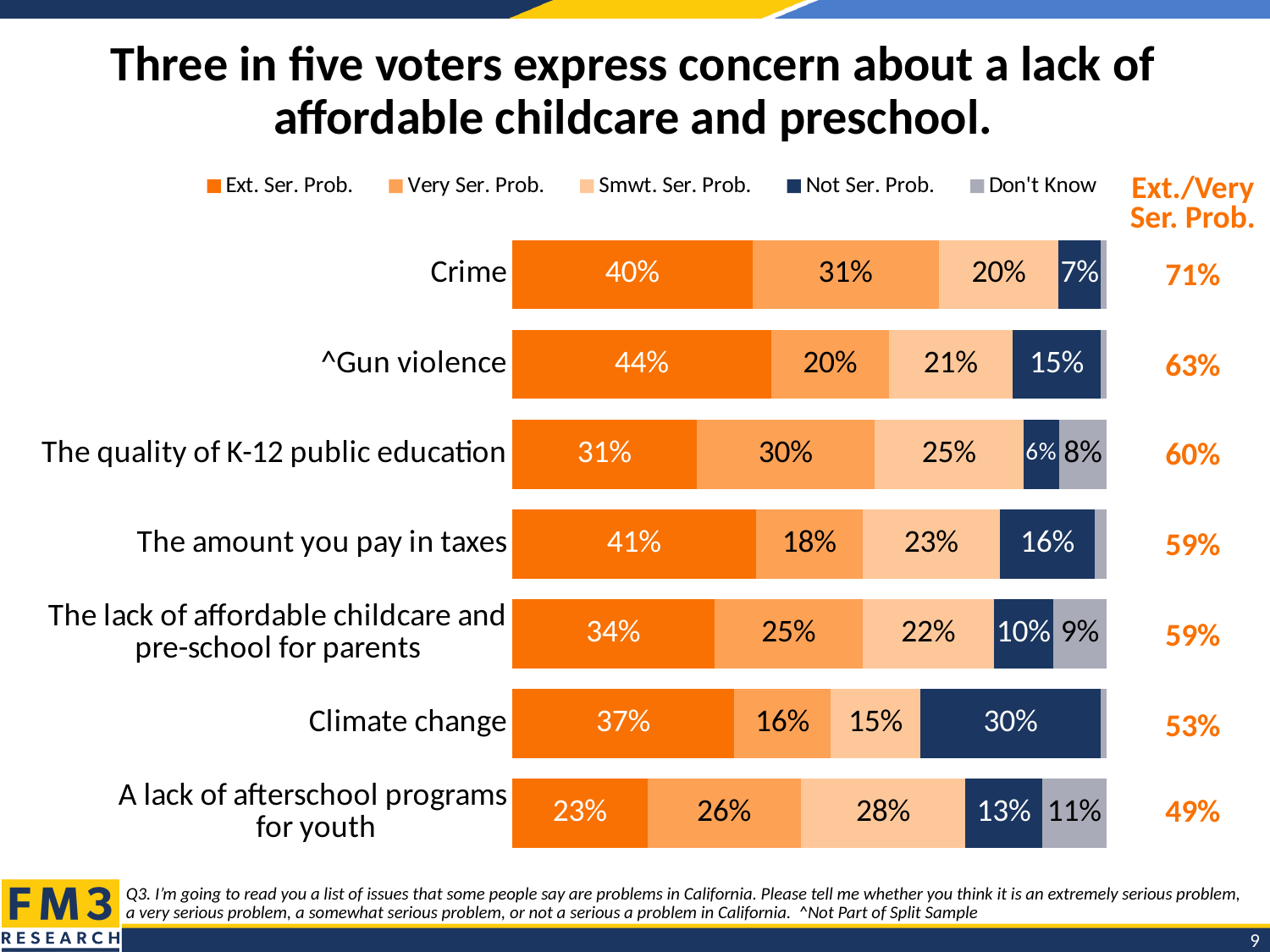
How many series does the legend list? 5 Which has a larger Smwt. Ser. Prob. value: a lack of afterschool programs for youth or climate change? A lack of afterschool programs for youth What is the combined Ext./Very Ser. Prob. value for the lack of affordable childcare and pre-school for parents? 59% What is the Don't Know value for a lack of afterschool programs for youth? 11% What is the Not Ser. Prob. value for climate change? 30% Which issue has the highest Ext. Ser. Prob. percentage? ^Gun violence What kind of chart is shown on the slide? Stacked bar chart How many issues are listed in the chart? 7 What percentage of voters say crime is an extremely serious problem (Ext. Ser. Prob.)? 40% What is the difference between the Ext. Ser. Prob. values for the amount you pay in taxes and the lack of affordable childcare and pre-school for parents? 7 percentage points How many percentage points higher is the Ext./Very Ser. Prob. value for crime than for gun violence? 8 percentage points Which issue has the lowest combined Ext./Very Ser. Prob. percentage? A lack of afterschool programs for youth